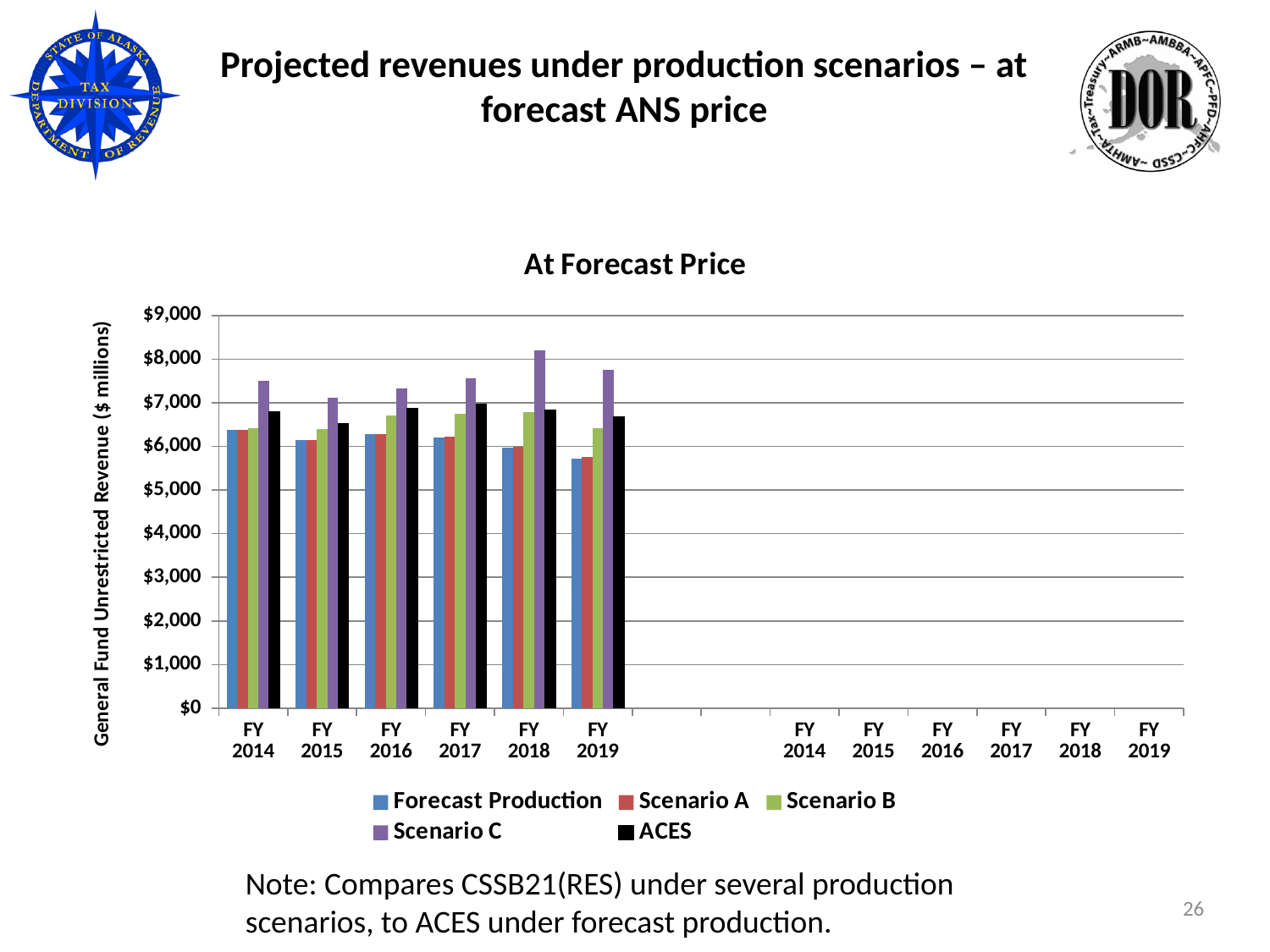
What is the title of the chart? At Forecast Price How many series does the legend list? 5 Is the value for ACES in FY 2014 greater or less than $7,000? less Is the value for Forecast Production in FY 2019 greater or less than $6,000? less In which fiscal year is the Scenario C bar the highest? FY 2018 Which is larger in FY 2017, Scenario C or ACES? Scenario C In which fiscal year is the Forecast Production bar the lowest? FY 2019 Which series has the highest bar in FY 2014? Scenario C Which is larger in FY 2018, Scenario A or Scenario B? Scenario B What kind of chart is shown on the slide? bar chart What is the label on the vertical axis? General Fund Unrestricted Revenue ($ millions) Is the value for Scenario C in FY 2018 greater or less than $8,000? greater